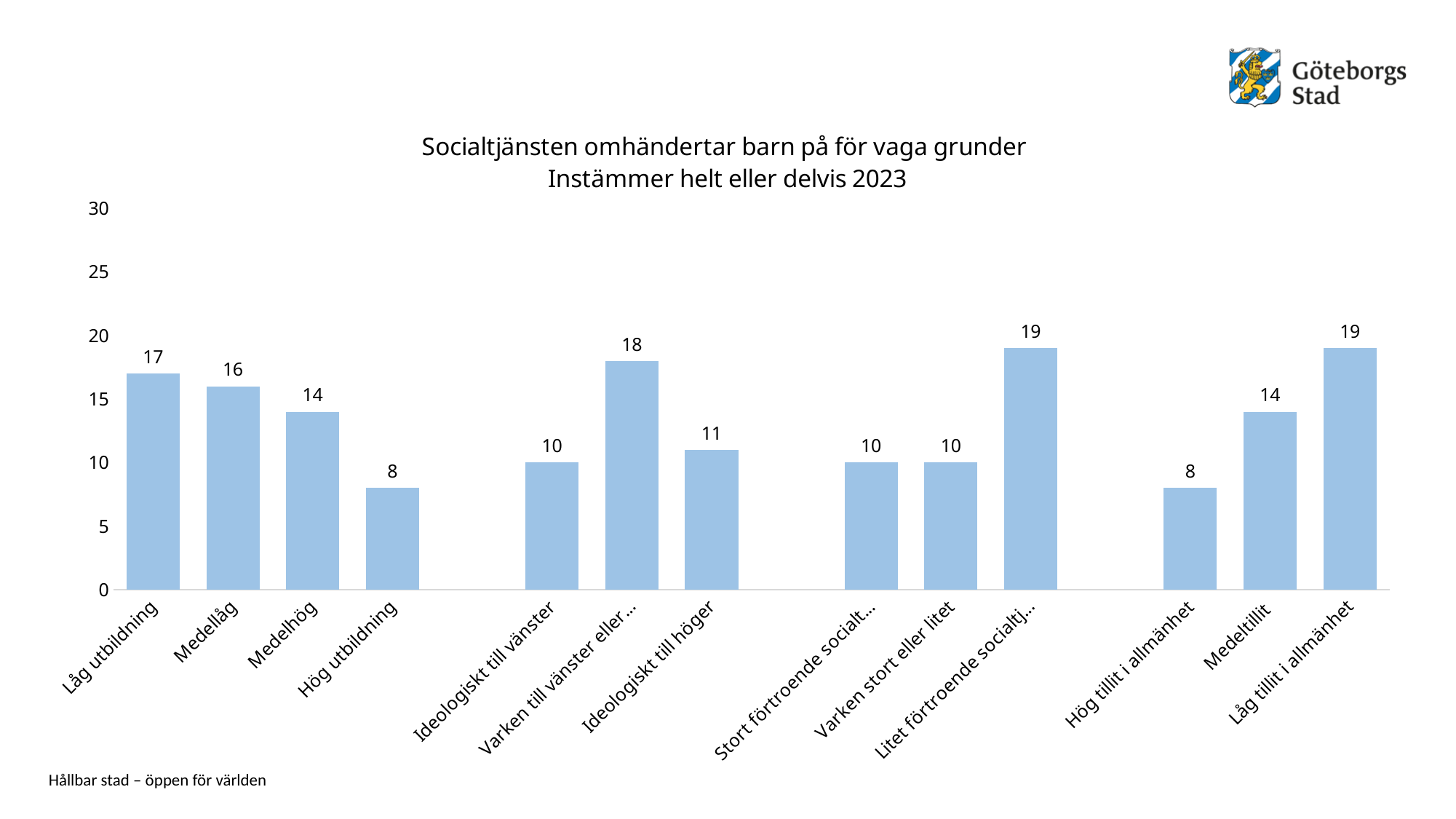
What is the value for Ideologiskt till höger? 11 What is the value for Låg utbildning? 17 How many bars are shown in the chart? 13 What is the difference between the values for Låg utbildning and Hög utbildning? 9 Which is larger, the value for Ideologiskt till vänster or the value for Ideologiskt till höger? Ideologiskt till höger What is the value for Låg tillit i allmänhet? 19 What is the value for Hög utbildning? 8 What is the value for Medeltillit? 14 What kind of chart is shown on the slide? Bar chart Among the education categories (Låg utbildning, Medellåg, Medelhög, Hög utbildning), which has the lowest value? Hög utbildning Among the tillit categories (Hög tillit i allmänhet, Medeltillit, Låg tillit i allmänhet), which has the highest value? Låg tillit i allmänhet Do the values rise or fall from Låg utbildning to Hög utbildning? Fall